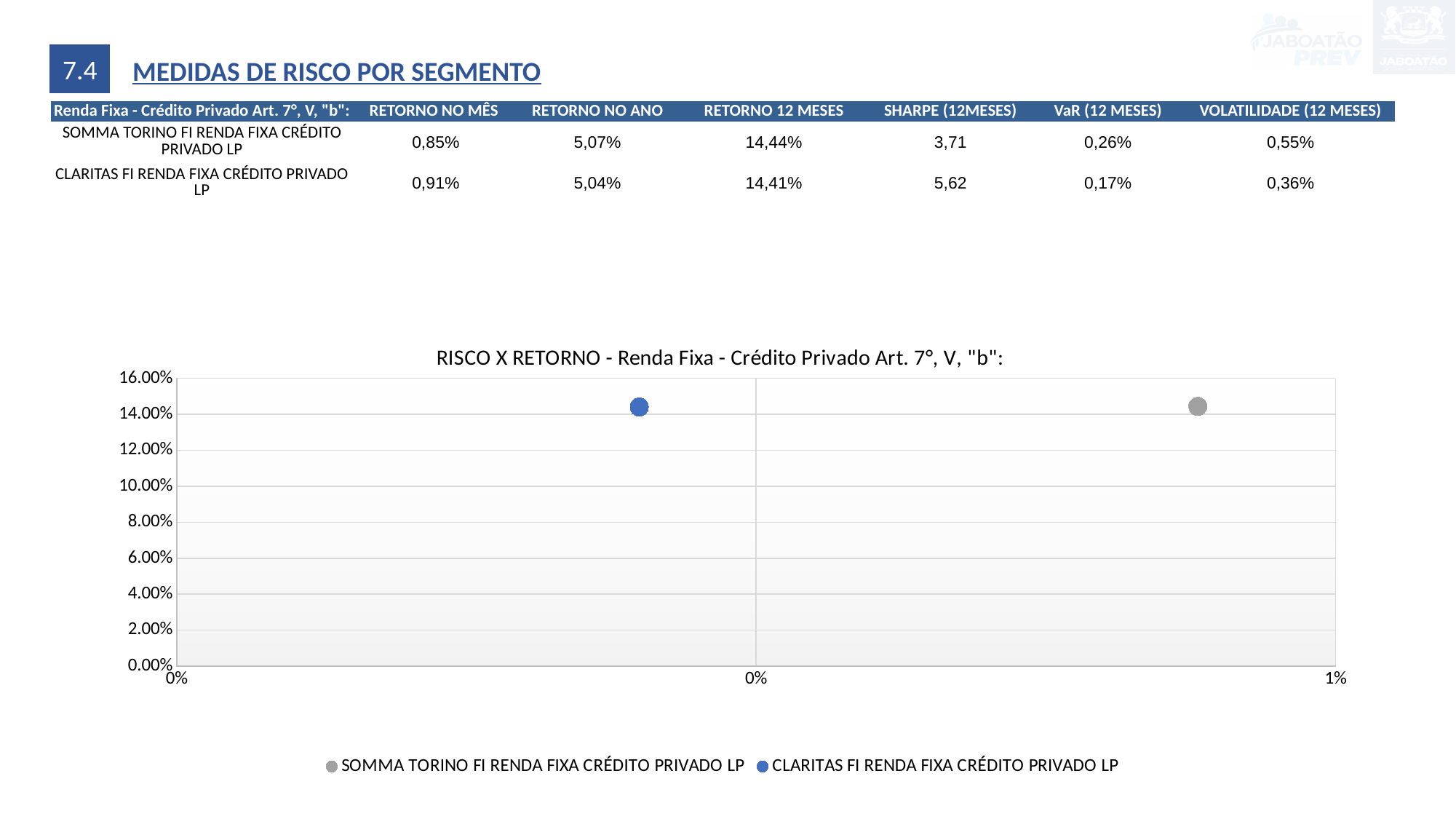
Is the vertical-axis value of the SOMMA TORINO FI RENDA FIXA CRÉDITO PRIVADO LP point greater or less than 12.00%? greater Is the vertical-axis value of the CLARITAS FI RENDA FIXA CRÉDITO PRIVADO LP point greater or less than 10.00%? greater How many data points are plotted on the chart? 2 Is the vertical-axis value of the CLARITAS FI RENDA FIXA CRÉDITO PRIVADO LP point greater or less than 16.00%? less Which series is shown with a blue marker in the chart? CLARITAS FI RENDA FIXA CRÉDITO PRIVADO LP What kind of chart is shown on the slide? scatter chart Which series is plotted further to the right (higher risk) on the chart? SOMMA TORINO FI RENDA FIXA CRÉDITO PRIVADO LP What is the title of the chart on the slide? RISCO X RETORNO - Renda Fixa - Crédito Privado Art. 7°, V, "b": How many series does the chart legend list? 2 What is the highest tick value shown on the vertical axis of the chart? 16.00%